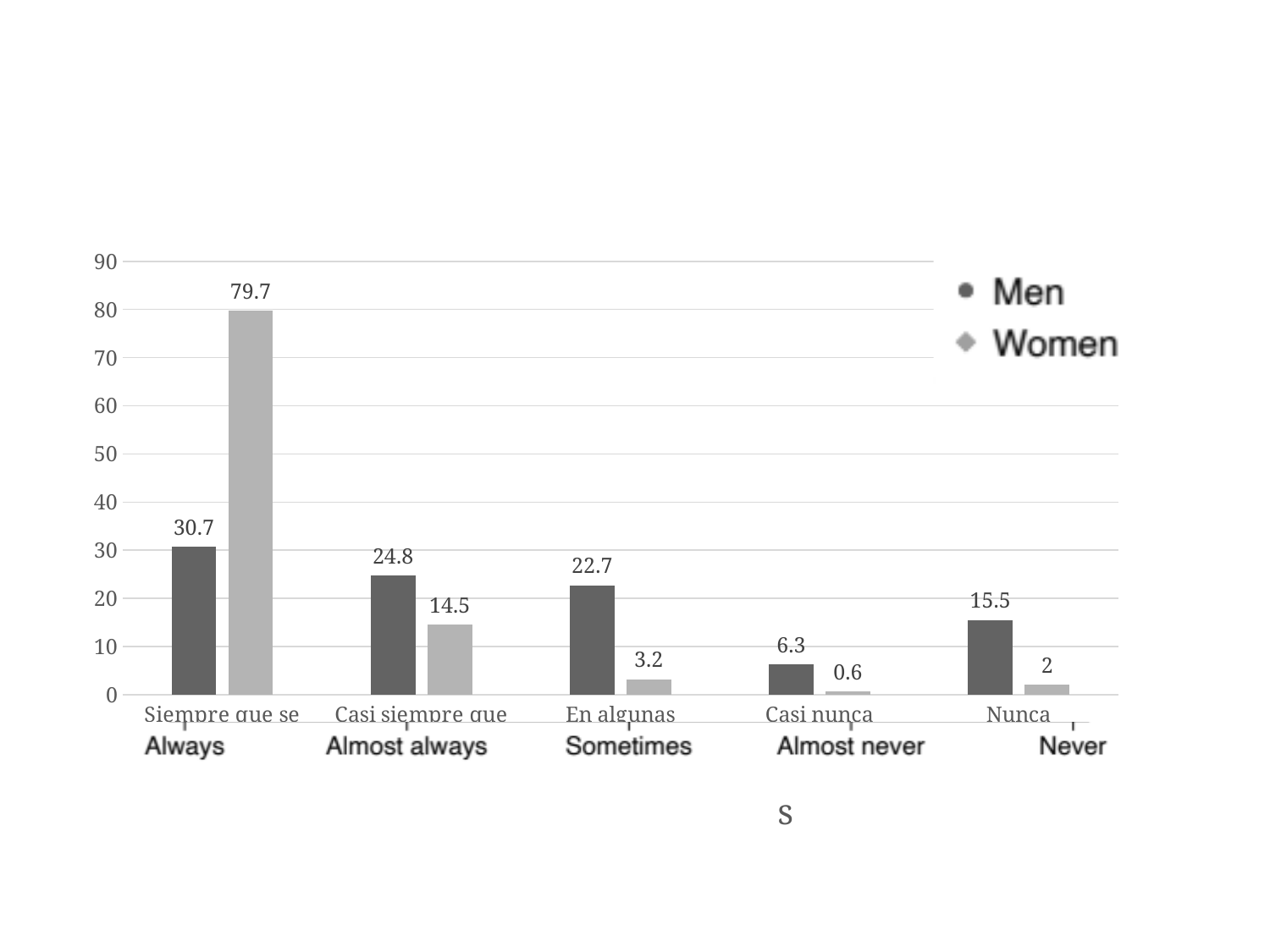
What is the value for Women in the Almost never category? 0.6 Which is larger in the Sometimes category, the Men value or the Women value? Men How many series does the legend list? 2 What is the value for Men in the Never category? 15.5 What is the difference between the Men and Women values in the Almost always category? 10.3 Which category has the lowest value for Women? Almost never Which category has the highest value for Men? Always What is the value for Men in the Sometimes category? 22.7 What is the value for Women in the Always category? 79.7 What is the difference between the Women and Men values in the Always category? 49 How many categories are shown on the x axis? 5 What kind of chart is shown on the slide? Bar chart